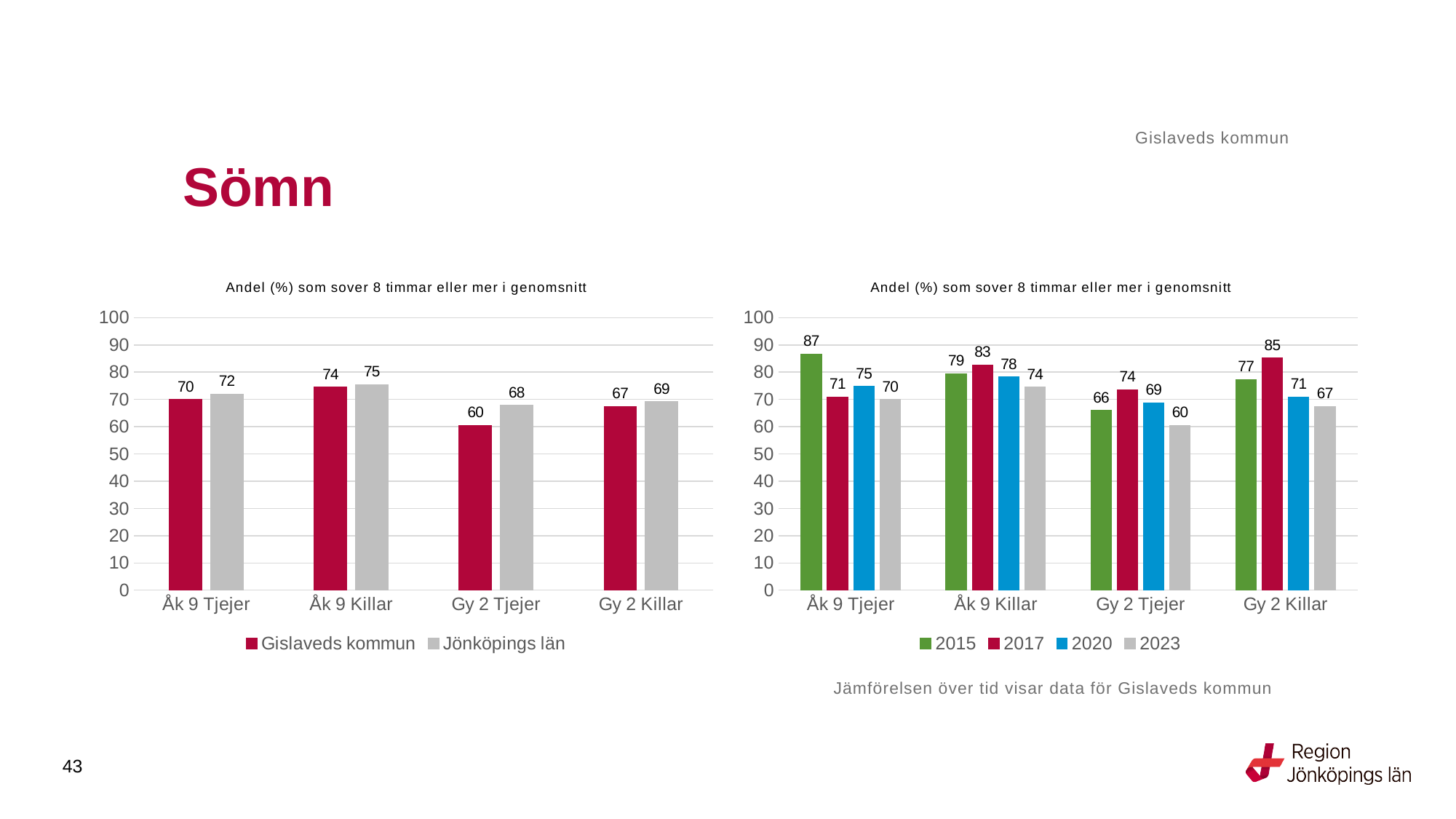
In the right chart, what is the value for 2015 for Åk 9 Tjejer? 87 In the left chart, which category has the lowest value for Gislaveds kommun? Gy 2 Tjejer In the left chart, what is the value for Gislaveds kommun for Gy 2 Tjejer? 60 In the right chart, which is larger for Gy 2 Tjejer: the 2017 value or the 2020 value? 2017 In the left chart, how many series does the legend list? 2 In the right chart, what is the value for 2023 for Gy 2 Killar? 67 In the right chart, how many series does the legend list? 4 What kind of chart is the left chart? Bar chart In the left chart, what is the difference between Jönköpings län and Gislaveds kommun for Gy 2 Tjejer? 8 In the left chart, what is the value for Jönköpings län for Åk 9 Killar? 75 In the right chart, which category has the highest value for 2017? Gy 2 Killar In the right chart, what is the difference between the 2015 and 2023 values for Åk 9 Tjejer? 17